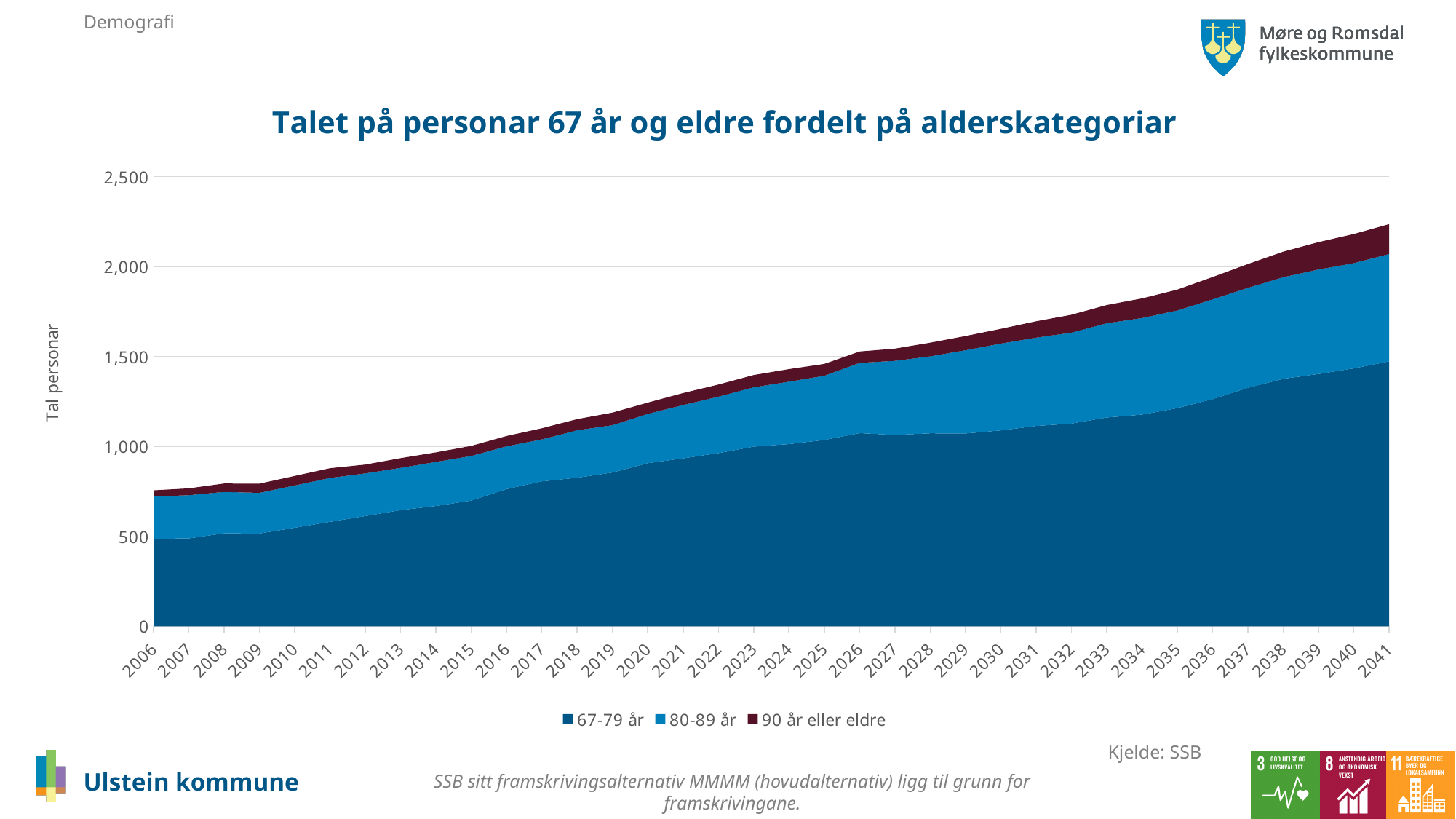
Does the total number of persons 67 years and older rise or fall from 2006 to 2041? Rise Is the total value for 2006 greater or less than 1,000? less What kind of chart is shown on the slide? Stacked area chart How many years are shown along the x axis? 36 Is the total value for 2020 greater or less than 1,500? less Which year is the first on the x axis? 2006 Is the total value for 2006 greater or less than 500? greater Which series is larger in 2041, 67-79 år or 90 år eller eldre? 67-79 år Which year is the last on the x axis? 2041 How many series does the legend list? 3